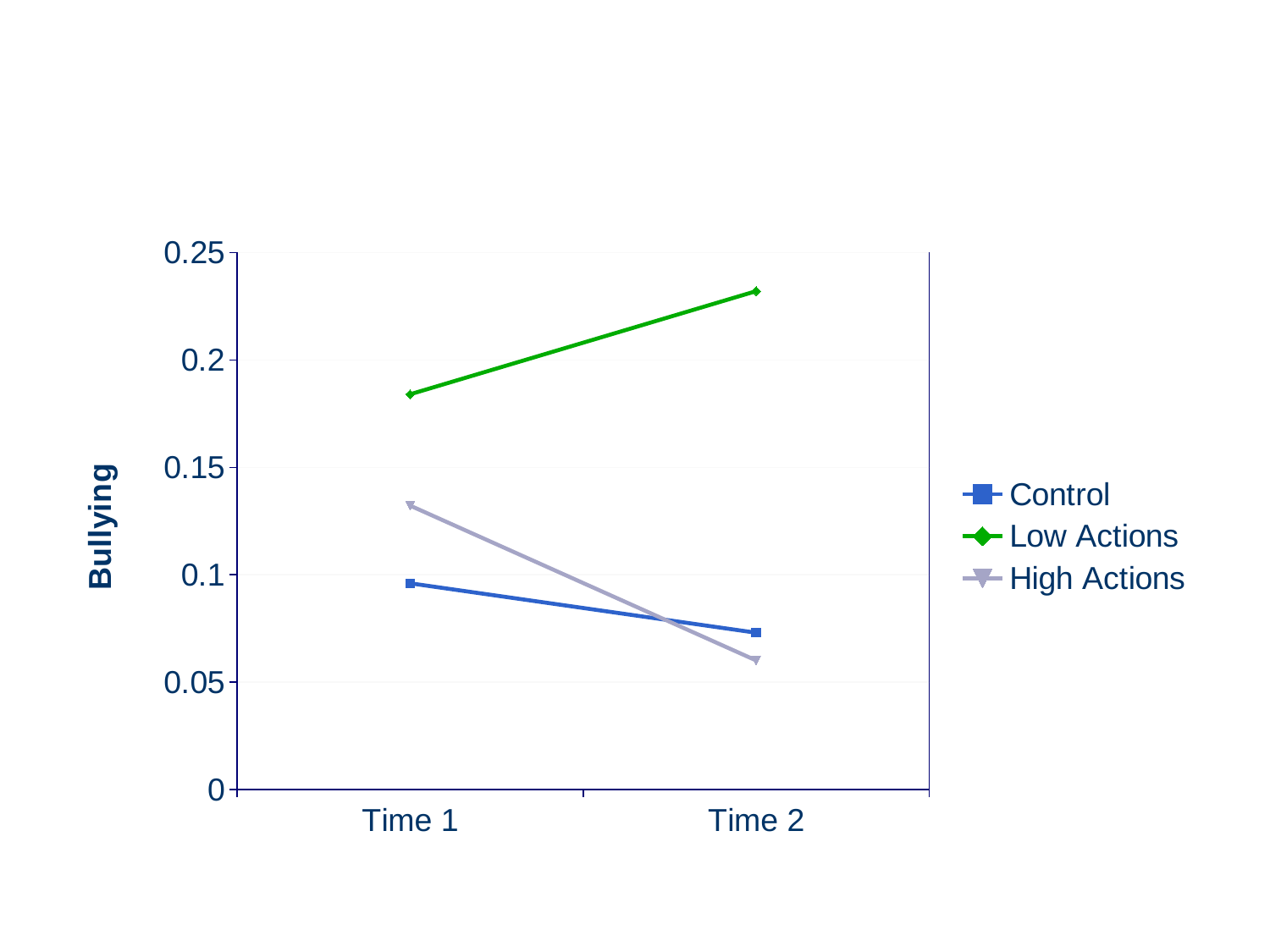
What is the label of the y axis? Bullying Does the Low Actions series rise or fall from Time 1 to Time 2? rise At Time 1, which is larger: the value for High Actions or the value for Control? High Actions How many time points are shown on the x axis? 2 Which series has the highest value at Time 2? Low Actions How many series does the legend list? 3 Does the High Actions series rise or fall from Time 1 to Time 2? fall Is the value for Low Actions at Time 2 greater or less than 0.2? greater Which series has the lowest value at Time 2? High Actions What kind of chart is shown on the slide? line chart Is the value for High Actions at Time 2 greater or less than 0.1? less Is the value for High Actions at Time 1 greater or less than 0.1? greater